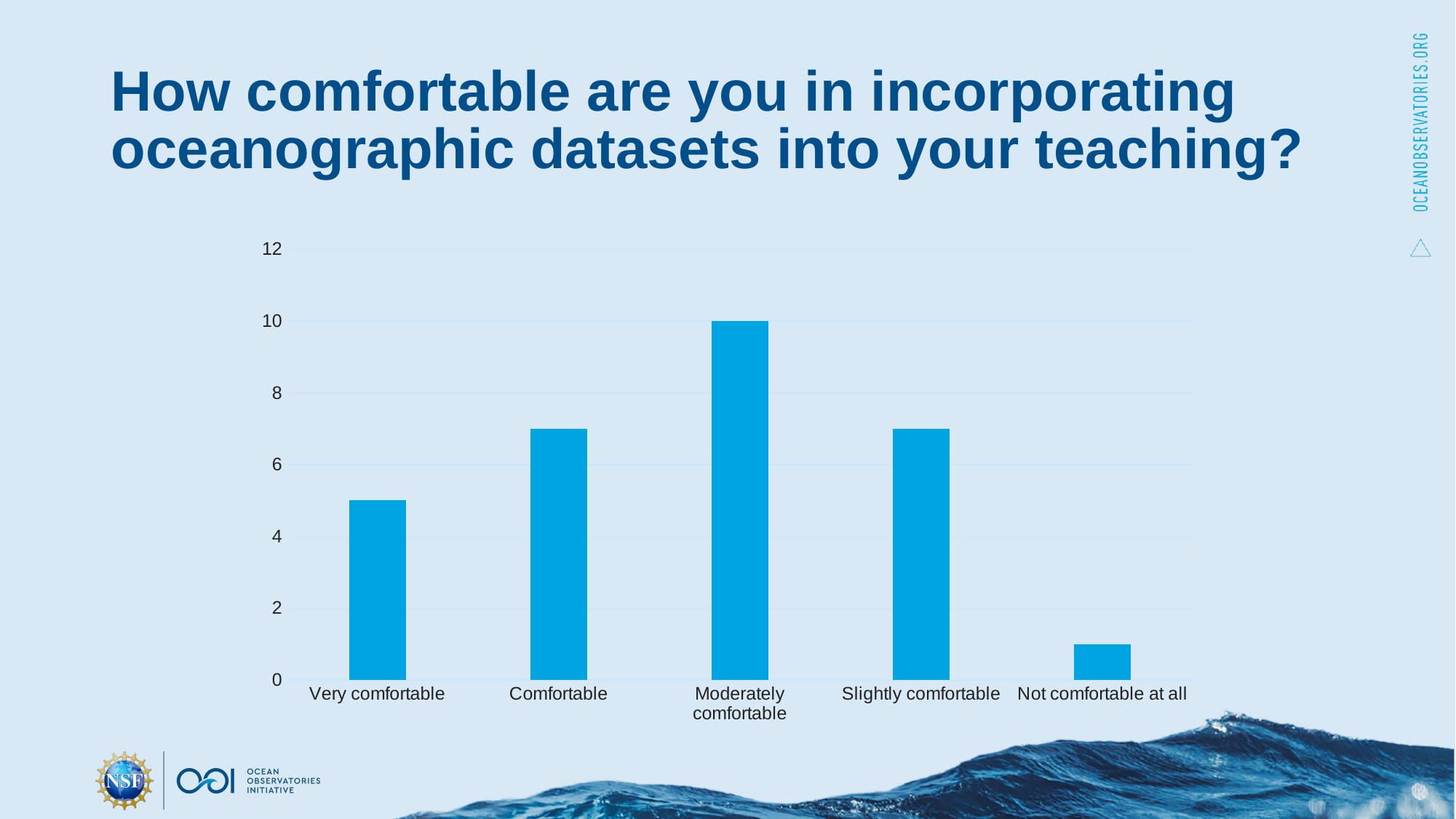
Is the value for Comfortable greater or less than 6? greater What is the title of the slide containing the chart? How comfortable are you in incorporating oceanographic datasets into your teaching? Is the value for Very comfortable greater or less than 4? greater How many categories are shown on the x axis of the chart? 5 Do the values rise or fall from Moderately comfortable to Not comfortable at all along the x axis? fall What kind of chart is shown on the slide? bar chart Which is larger, the value for Moderately comfortable or the value for Very comfortable? Moderately comfortable Which category has the highest value? Moderately comfortable What is the value for Moderately comfortable? 10 Which category has the lowest value? Not comfortable at all Is the value for Not comfortable at all greater or less than 2? less